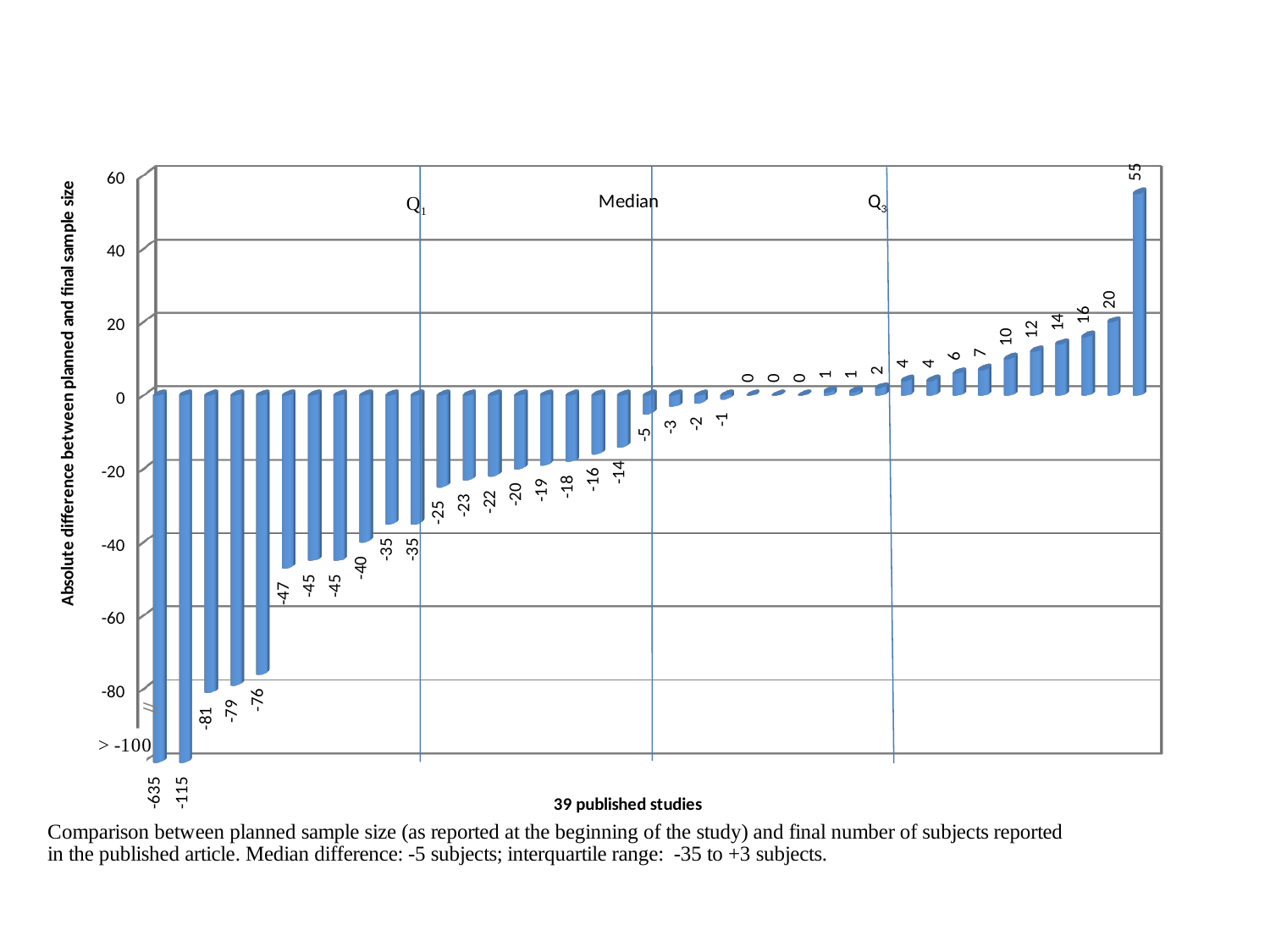
What is the highest value shown by any bar in the chart? 55 What is the label of the y axis? Absolute difference between planned and final sample size What is the lowest value shown by any bar in the chart? -635 What is the value of the rightmost bar in the chart? 55 What is the label of the x axis? 39 published studies What is the value of the leftmost bar in the chart? -635 What is the difference between the highest bar value (55) and the second highest bar value (20)? 35 How many published studies (bars) are plotted in the chart? 39 What is the value of the second bar from the left in the chart? -115 How many bars in the chart have a value of 0? 3 What kind of chart is shown on the slide? Bar chart Do the bar values rise or fall moving from left to right along the x axis? Rise